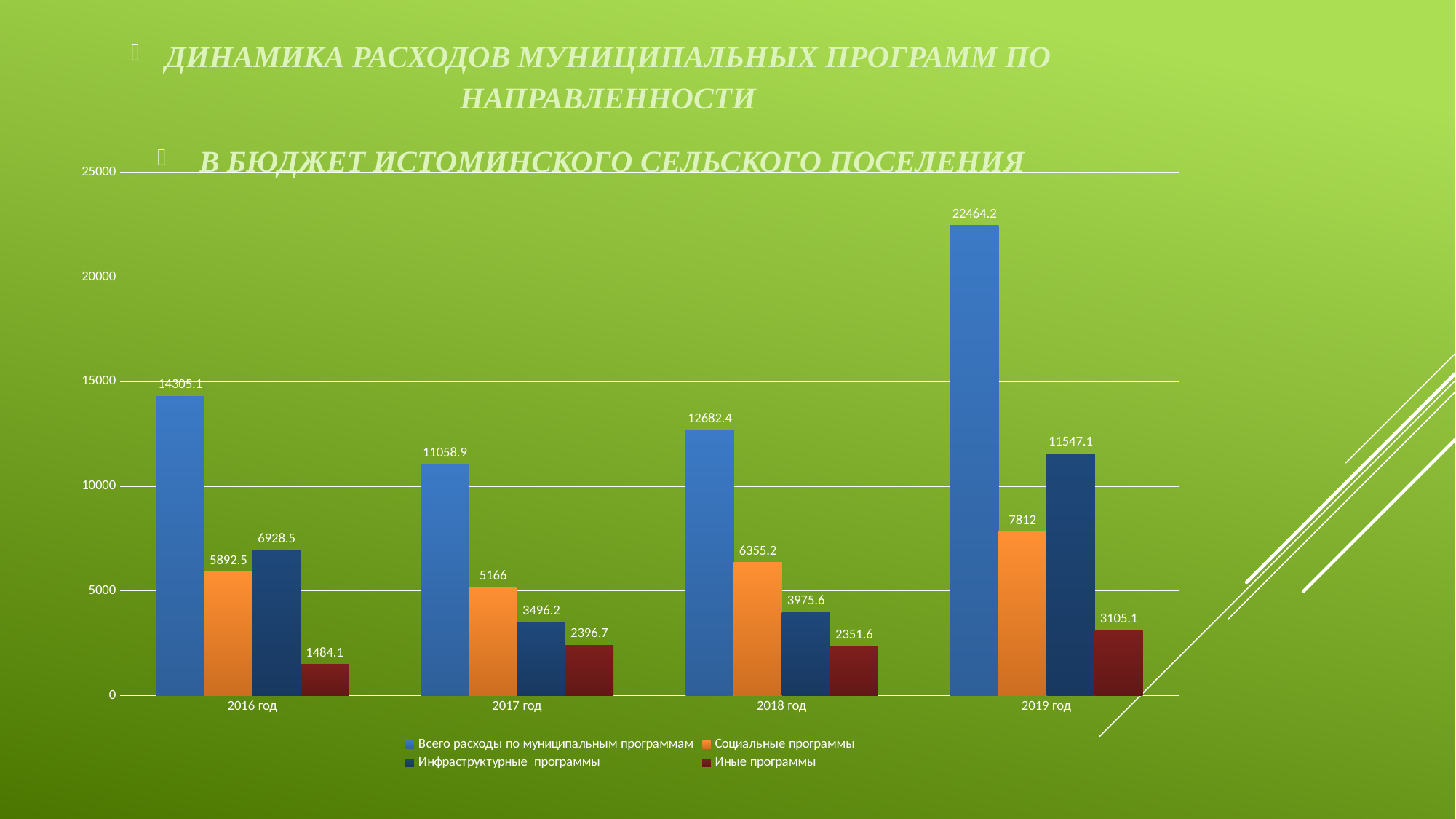
How many years are shown on the x axis? 4 In which year is the value for Всего расходы по муниципальным программам the highest? 2019 год Which is larger in 2016 год: Социальные программы or Инфраструктурные программы? Инфраструктурные программы What kind of chart is shown on the slide? bar chart What is the value for Иные программы in 2018 год? 2351.6 What is the value for Социальные программы in 2017 год? 5166 Is the value for Инфраструктурные программы in 2019 год greater or less than 10000? greater In which year is the value for Иные программы the lowest? 2016 год What is the value for Всего расходы по муниципальным программам in 2019 год? 22464.2 What is the difference between Всего расходы по муниципальным программам in 2019 год and in 2016 год? 8159.1 How many series does the legend list? 4 What is the value for Инфраструктурные программы in 2016 год? 6928.5